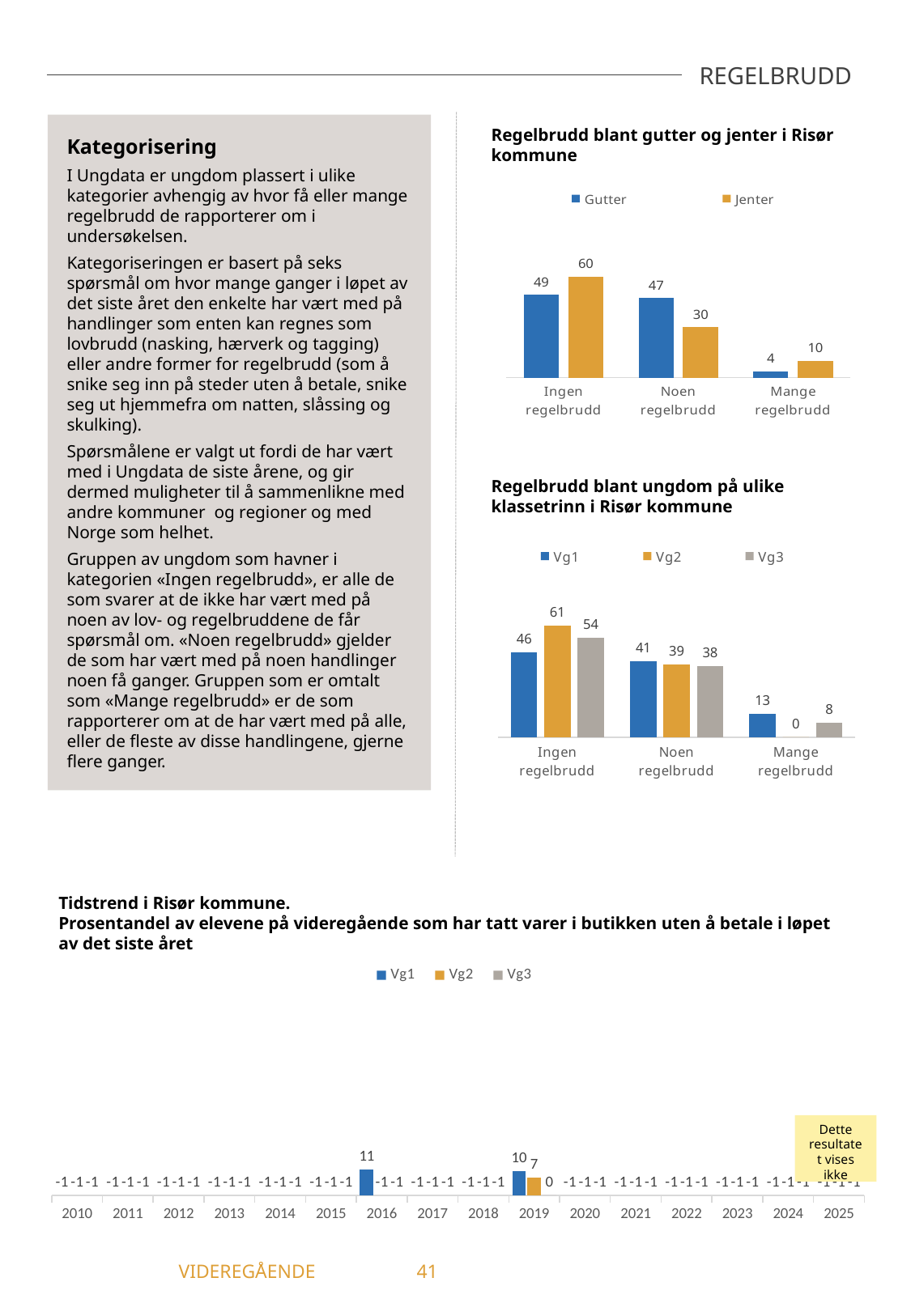
In the chart 'Regelbrudd blant ungdom på ulike klassetrinn i Risør kommune', what is the value for Vg2 in the 'Mange regelbrudd' category? 0 In the chart 'Regelbrudd blant ungdom på ulike klassetrinn i Risør kommune', which series has the highest value for 'Mange regelbrudd'? Vg1 In the chart 'Regelbrudd blant gutter og jenter i Risør kommune', which series has the higher value for 'Noen regelbrudd', Gutter or Jenter? Gutter In the chart 'Regelbrudd blant gutter og jenter i Risør kommune', what is the value for Jenter in the 'Ingen regelbrudd' category? 60 In the chart 'Regelbrudd blant gutter og jenter i Risør kommune', what is the value for Gutter in the 'Noen regelbrudd' category? 47 In the chart 'Regelbrudd blant gutter og jenter i Risør kommune', what is the difference between Jenter and Gutter in the 'Mange regelbrudd' category? 6 What kind of chart is 'Tidstrend i Risør kommune'? Bar chart In the chart 'Regelbrudd blant ungdom på ulike klassetrinn i Risør kommune', what is the difference between Vg2 and Vg3 in the 'Ingen regelbrudd' category? 7 In the chart 'Regelbrudd blant ungdom på ulike klassetrinn i Risør kommune', what is the value for Vg2 in the 'Ingen regelbrudd' category? 61 How many categories are shown on the x axis of the chart 'Regelbrudd blant ungdom på ulike klassetrinn i Risør kommune'? 3 How many series does the legend list in the chart 'Regelbrudd blant gutter og jenter i Risør kommune'? 2 In the chart 'Tidstrend i Risør kommune', what is the value for Vg1 in 2016? 11